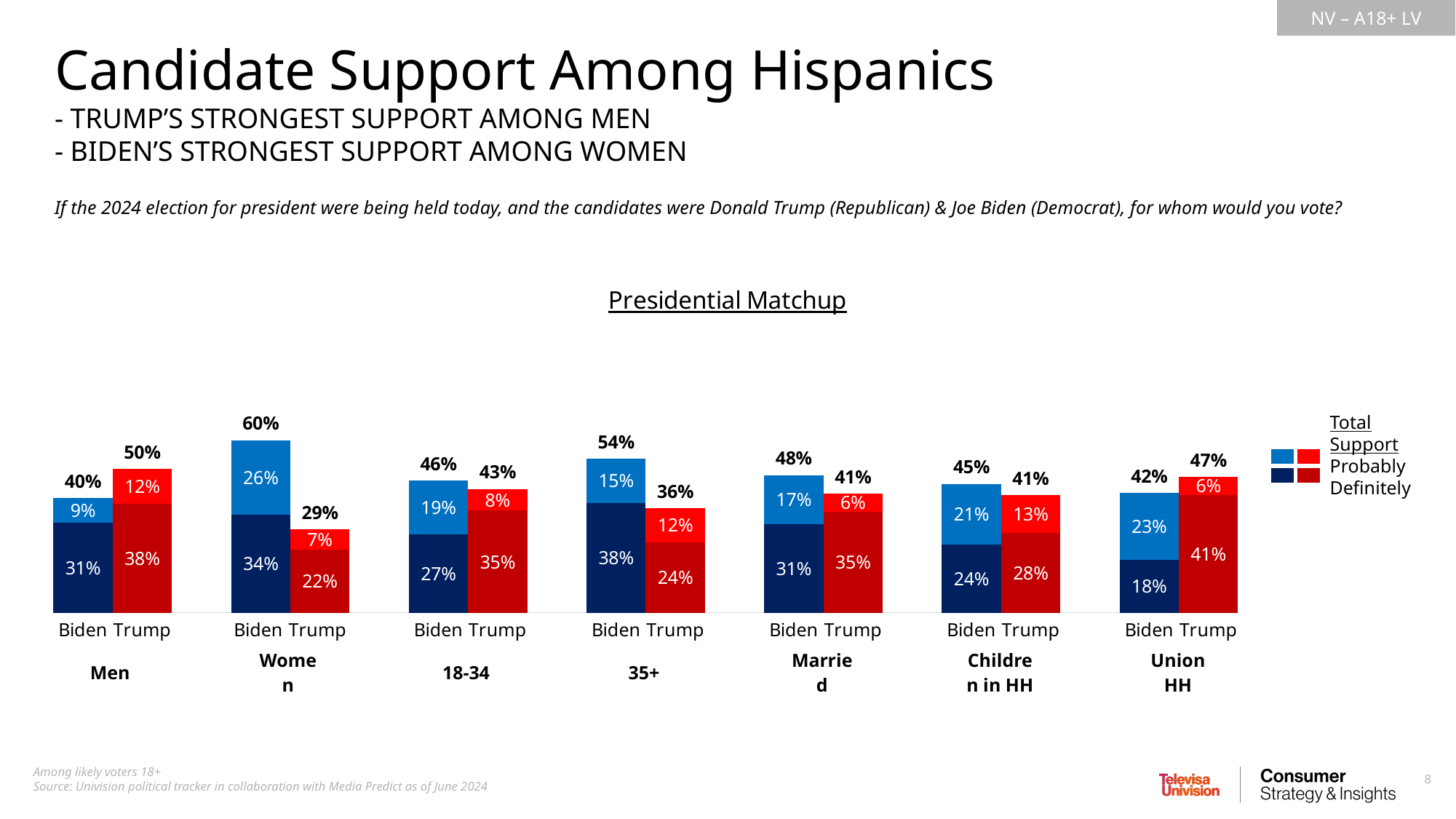
What kind of chart is the Presidential Matchup chart? Stacked bar chart Among Union HH voters, who has higher total support, Biden or Trump? Trump In which demographic group is Trump's total support lowest? Women What is the difference between Biden's and Trump's total support among 35+ voters? 18% What is the total support for Trump among Men? 50% In which demographic group is Biden's total support highest? Women Among Married voters, who has higher total support, Biden or Trump? Biden What two levels of support does the legend distinguish? Probably and Definitely How many demographic groups are shown on the x axis of the chart? 7 What share of Union HH voters say they would definitely vote for Trump? 41% What share of 18-34 voters say they would probably vote for Biden? 19% What is the total support for Biden among Women? 60%